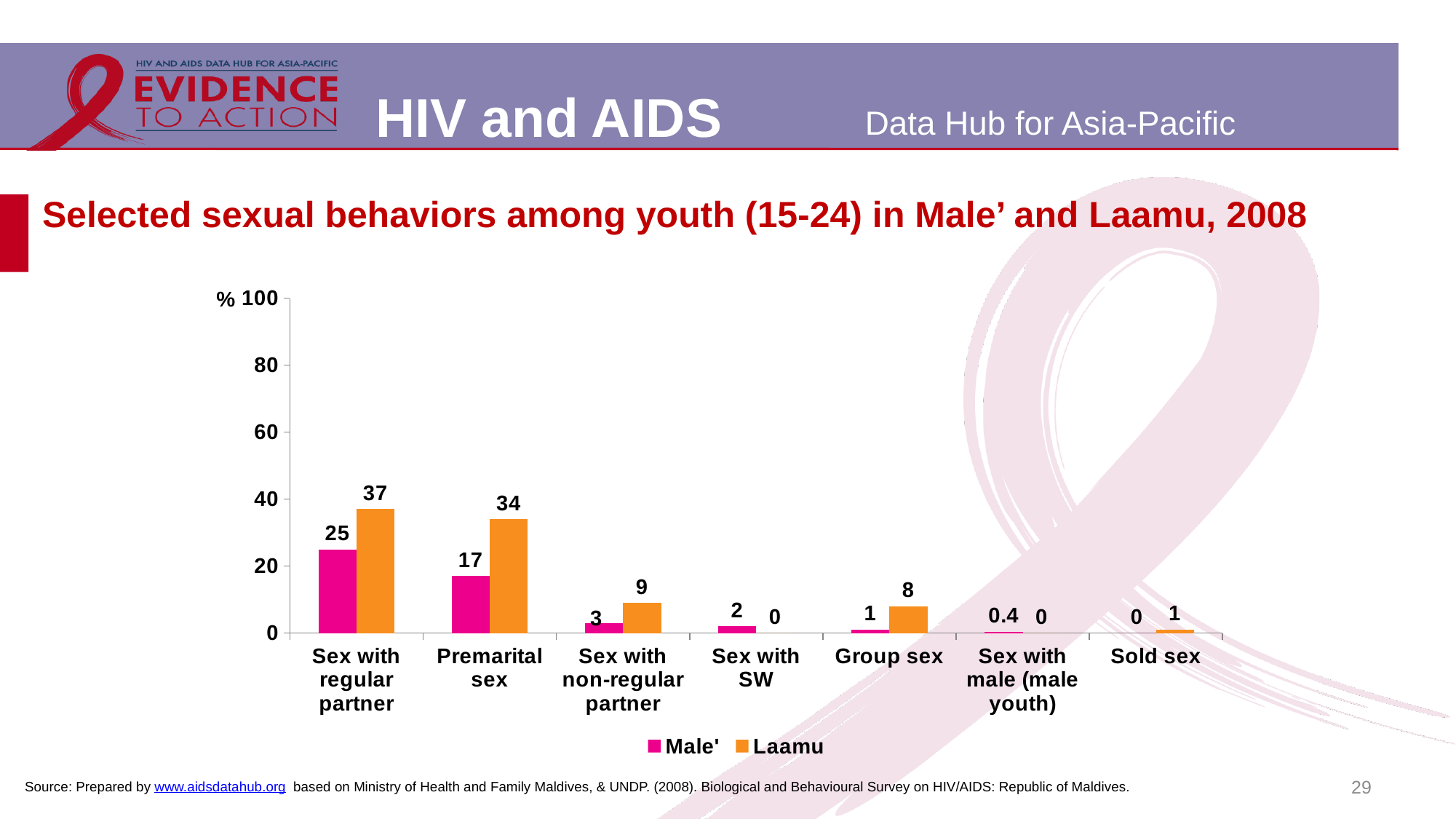
What is the difference between the Laamu and Male' values for 'Sex with regular partner'? 12 How many categories are shown on the x axis? 7 What is the value for Male' for 'Sex with male (male youth)'? 0.4 Which colour represents Laamu in the chart? Orange Which category has the highest value for Laamu? Sex with regular partner What is the value for Laamu for 'Sex with regular partner'? 37 What kind of chart is shown on the slide? Bar chart What is the value for Laamu for 'Group sex'? 8 How many series does the legend list? 2 What is the value for Male' for 'Premarital sex'? 17 Which category has the lowest value for Male'? Sold sex For 'Sex with SW', which is larger: the Male' value or the Laamu value? Male'